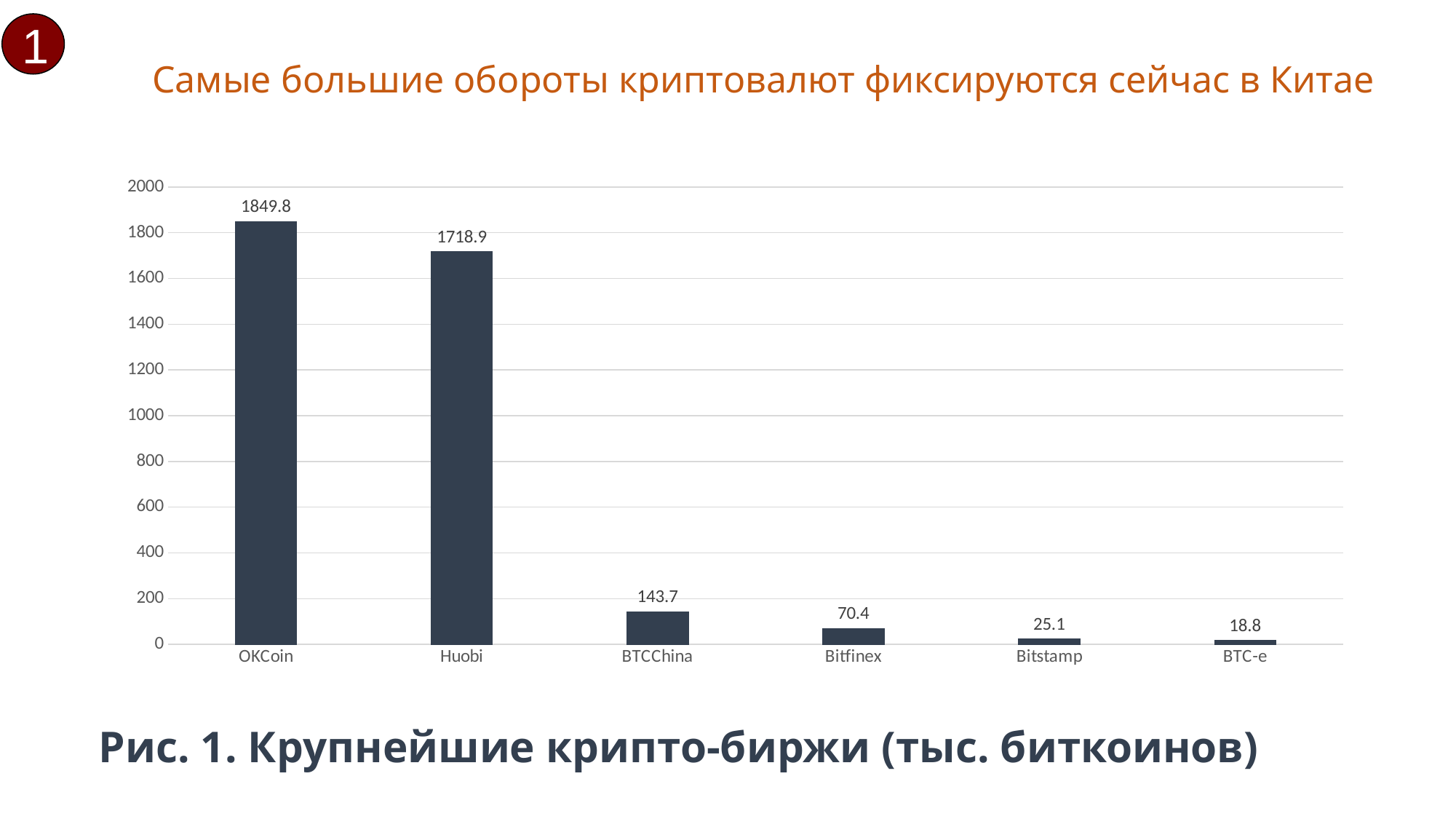
What is the value for Bitstamp? 25.1 How many exchanges are shown on the chart? 6 Which is larger, the value for BTCChina or the value for Bitfinex? BTCChina Which exchange has the lowest value? BTC-e What is the difference between the values for Bitfinex and BTC-e? 51.6 What kind of chart is shown on the slide? Bar chart Is the value for Huobi greater or less than 1600? greater What is the value for Huobi? 1718.9 What is the value for BTCChina? 143.7 What is the value for OKCoin? 1849.8 Which exchange has the highest value? OKCoin What is the difference between the values for OKCoin and Huobi? 130.9